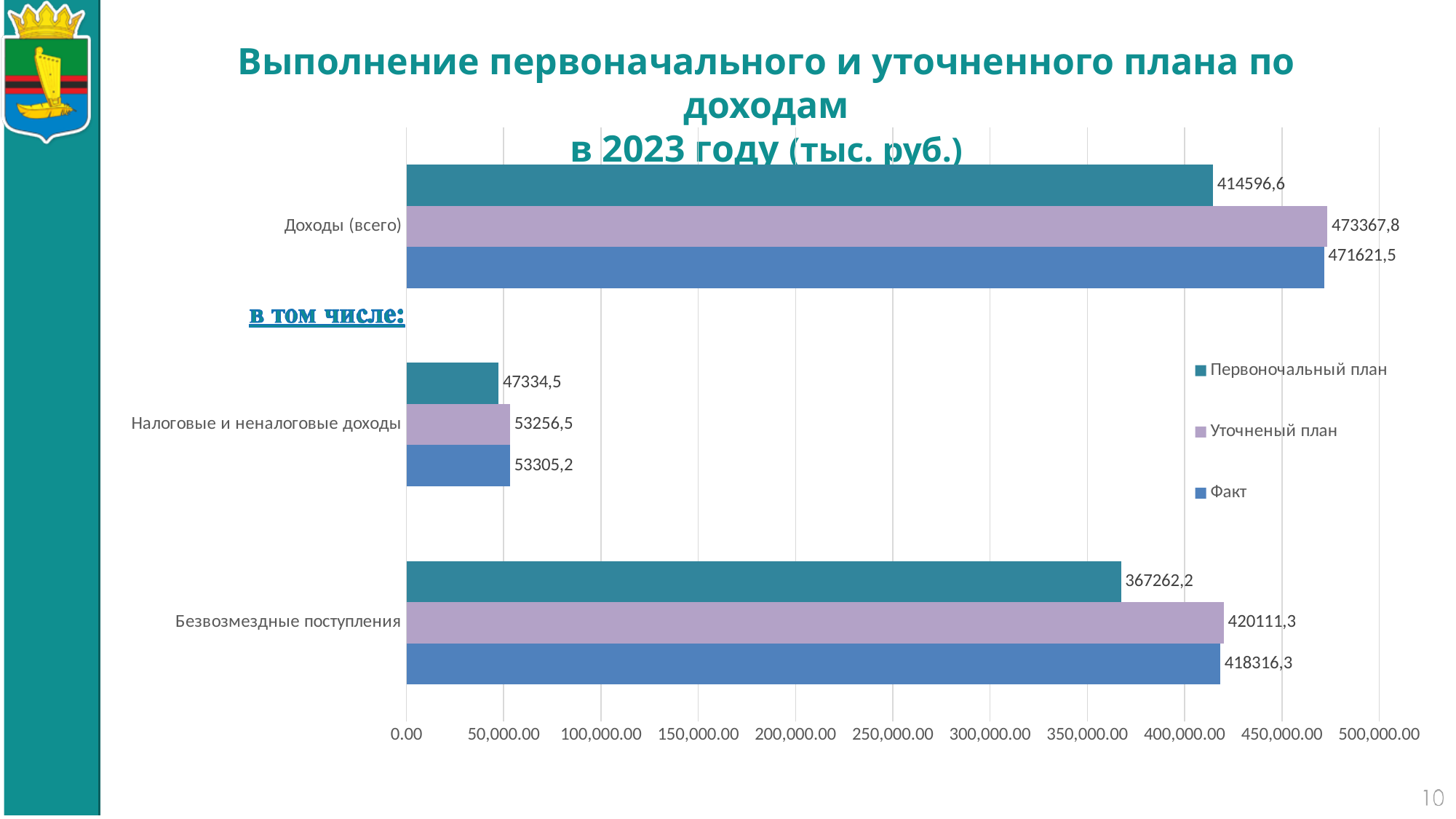
Which category has the highest Уточненый план value? Доходы (всего) What is the difference between the Уточненый план and Первоночальный план values for Доходы (всего)? 58771,2 For Безвозмездные поступления, which is larger: the Первоночальный план value or the Факт value? Факт What is the Уточненый план value for Налоговые и неналоговые доходы? 53256,5 Is the Первоночальный план value for Безвозмездные поступления greater or less than 400,000.00? less What is the difference between the Факт and Первоночальный план values for Налоговые и неналоговые доходы? 5970,7 How many series does the legend list? 3 What kind of chart is shown on the slide? bar chart Which category has the lowest Первоночальный план value? Налоговые и неналоговые доходы What is the Первоночальный план value for Безвозмездные поступления? 367262,2 How many categories are shown on the chart? 3 What is the Факт value for Доходы (всего)? 471621,5